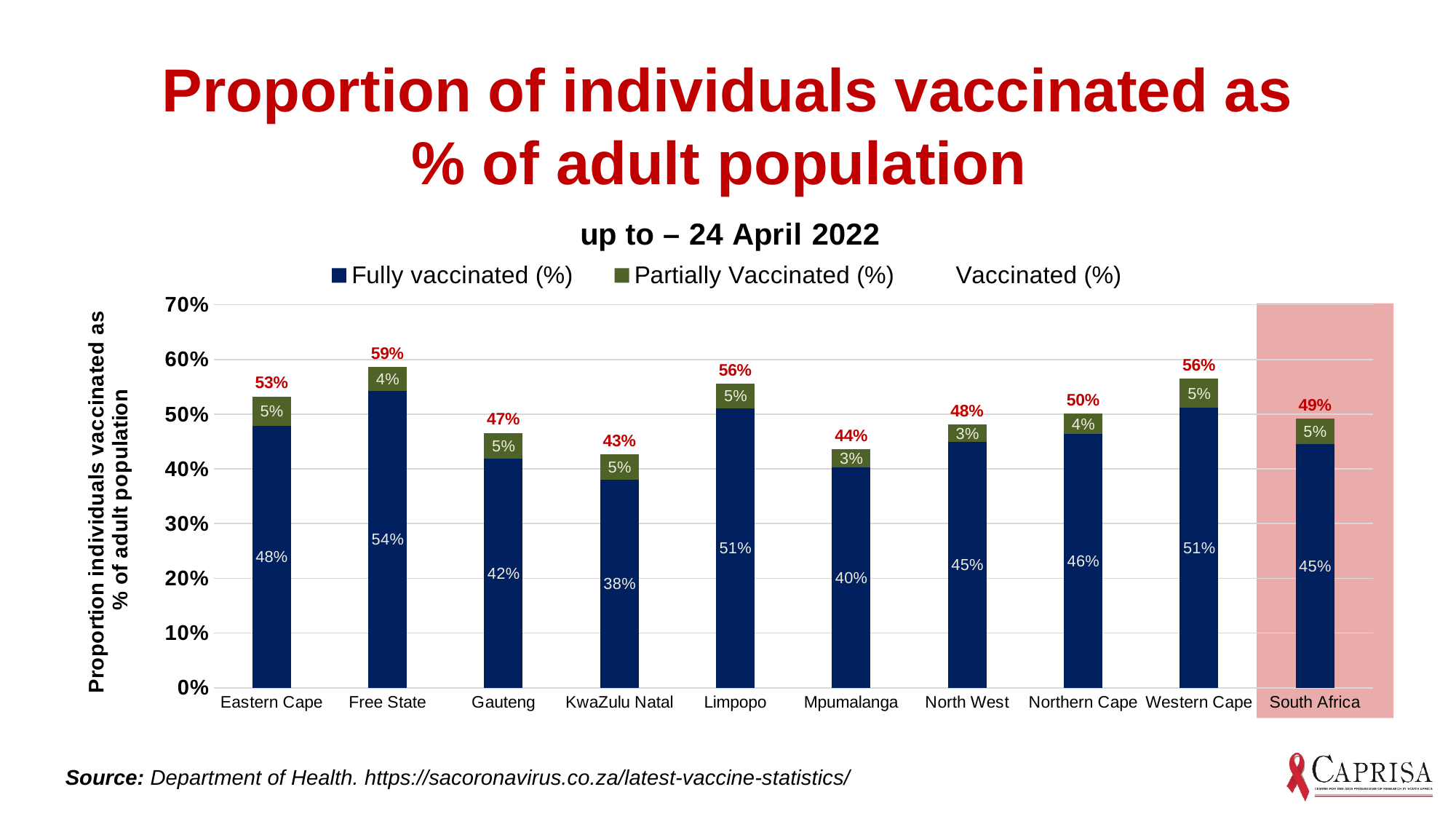
How many categories are shown on the x axis? 10 What is the total Vaccinated (%) label shown above the Limpopo bar? 56% What kind of chart is shown on the slide? Stacked bar chart What is the difference in Fully vaccinated (%) between Free State and KwaZulu Natal? 16 percentage points Which province has the highest overall Vaccinated (%) value? Free State What is the Partially Vaccinated (%) value for Mpumalanga? 3% Which category is highlighted with a pink background? South Africa How many series does the legend list? 3 Which has a higher Fully vaccinated (%) value, Gauteng or Northern Cape? Northern Cape What is the overall Vaccinated (%) value shown for South Africa? 49% Which province has the lowest overall Vaccinated (%) value? KwaZulu Natal What is the Fully vaccinated (%) value for Free State? 54%